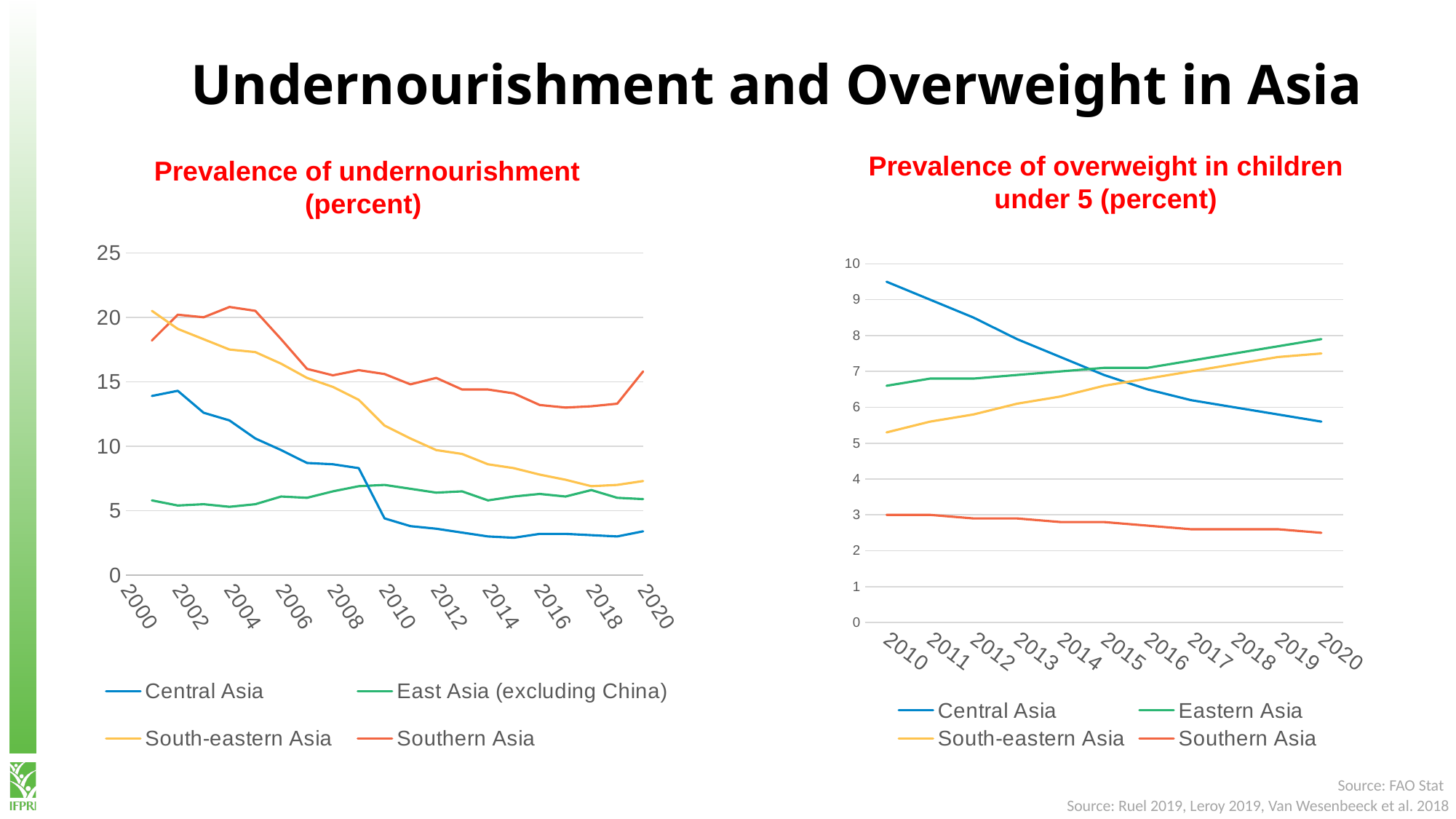
In the 'Prevalence of undernourishment (percent)' chart, does the Central Asia line rise or fall from 2000 to 2020? Fall How many series does the legend of the 'Prevalence of overweight in children under 5 (percent)' chart list? 4 What kind of chart is the 'Prevalence of undernourishment (percent)' chart on the left? Line chart How many years are labelled on the x axis of the 'Prevalence of overweight in children under 5 (percent)' chart? 11 In the 'Prevalence of overweight in children under 5 (percent)' chart, which region has the lowest value in 2020? Southern Asia In the 'Prevalence of undernourishment (percent)' chart, which region has the lowest value in 2020? Central Asia In the 'Prevalence of undernourishment (percent)' chart, is the value for South-eastern Asia in 2020 greater or less than 10? less In the 'Prevalence of undernourishment (percent)' chart, which is larger in 2000: Central Asia or East Asia (excluding China)? Central Asia In the 'Prevalence of overweight in children under 5 (percent)' chart, which region has the highest value in 2010? Central Asia In the 'Prevalence of overweight in children under 5 (percent)' chart, is the value for Central Asia in 2010 greater or less than 9? greater In the 'Prevalence of undernourishment (percent)' chart, which region has the highest value in 2020? Southern Asia In the 'Prevalence of overweight in children under 5 (percent)' chart, does the South-eastern Asia line rise or fall from 2010 to 2020? Rise